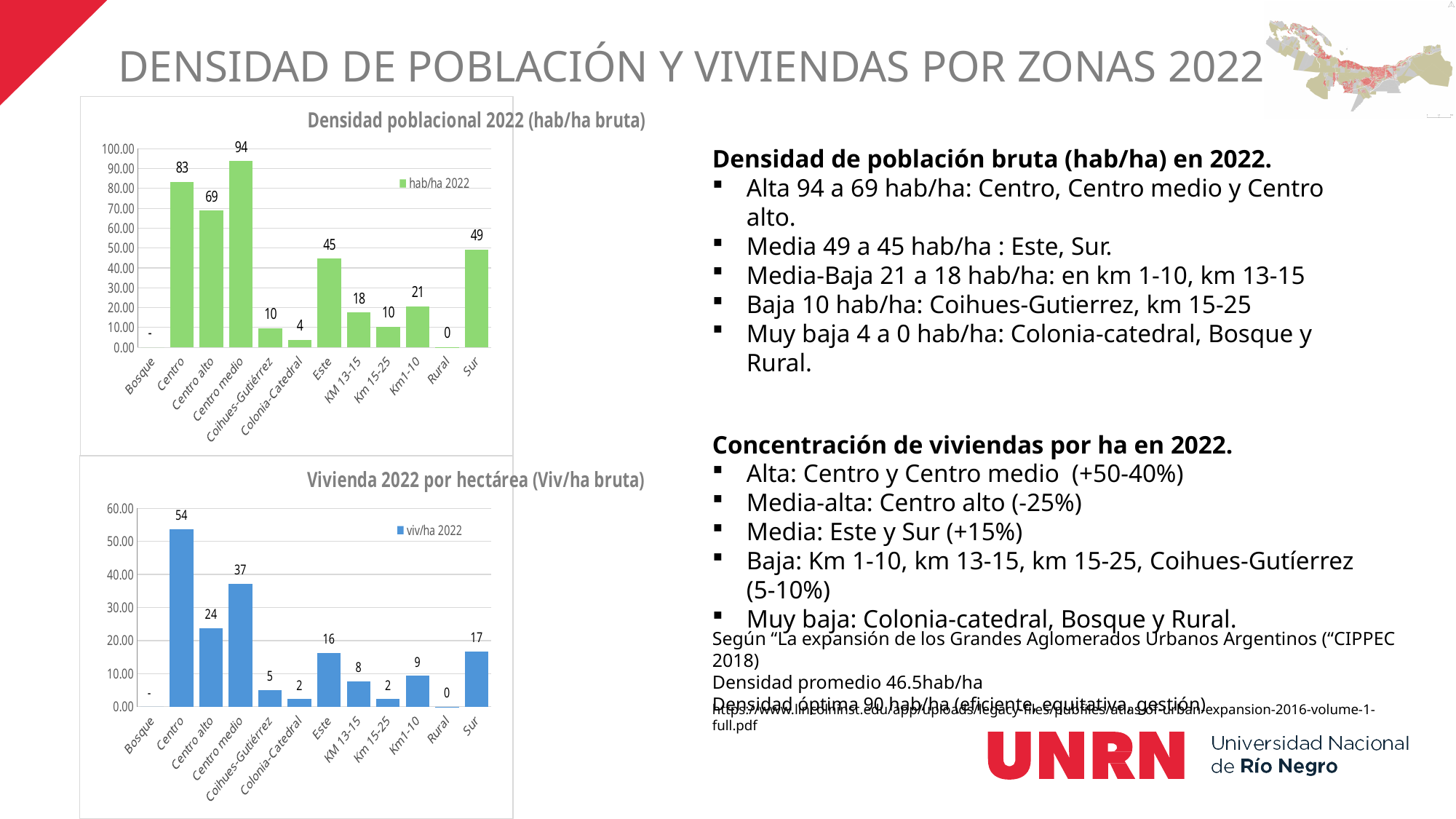
In the 'Densidad poblacional 2022 (hab/ha bruta)' chart, what is the difference between the values for Centro and Centro alto? 14 What series name does the legend of the 'Vivienda 2022 por hectárea (Viv/ha bruta)' chart show? viv/ha 2022 How many categories are shown on the x axis of the 'Vivienda 2022 por hectárea (Viv/ha bruta)' chart? 12 In the 'Densidad poblacional 2022 (hab/ha bruta)' chart, what is the value for Centro medio? 94 In the 'Densidad poblacional 2022 (hab/ha bruta)' chart, which is larger, the value for Este or the value for Sur? Sur In the 'Vivienda 2022 por hectárea (Viv/ha bruta)' chart, which is larger, the value for Este or the value for Sur? Sur In the 'Densidad poblacional 2022 (hab/ha bruta)' chart, what is the value for Km1-10? 21 In the 'Vivienda 2022 por hectárea (Viv/ha bruta)' chart, what is the value for Centro? 54 In the 'Densidad poblacional 2022 (hab/ha bruta)' chart, which category has the highest value? Centro medio In the 'Vivienda 2022 por hectárea (Viv/ha bruta)' chart, what is the difference between the values for Centro medio and Centro alto? 13 What type of chart is the 'Densidad poblacional 2022 (hab/ha bruta)' chart? Bar chart In the 'Vivienda 2022 por hectárea (Viv/ha bruta)' chart, which category has the highest value? Centro